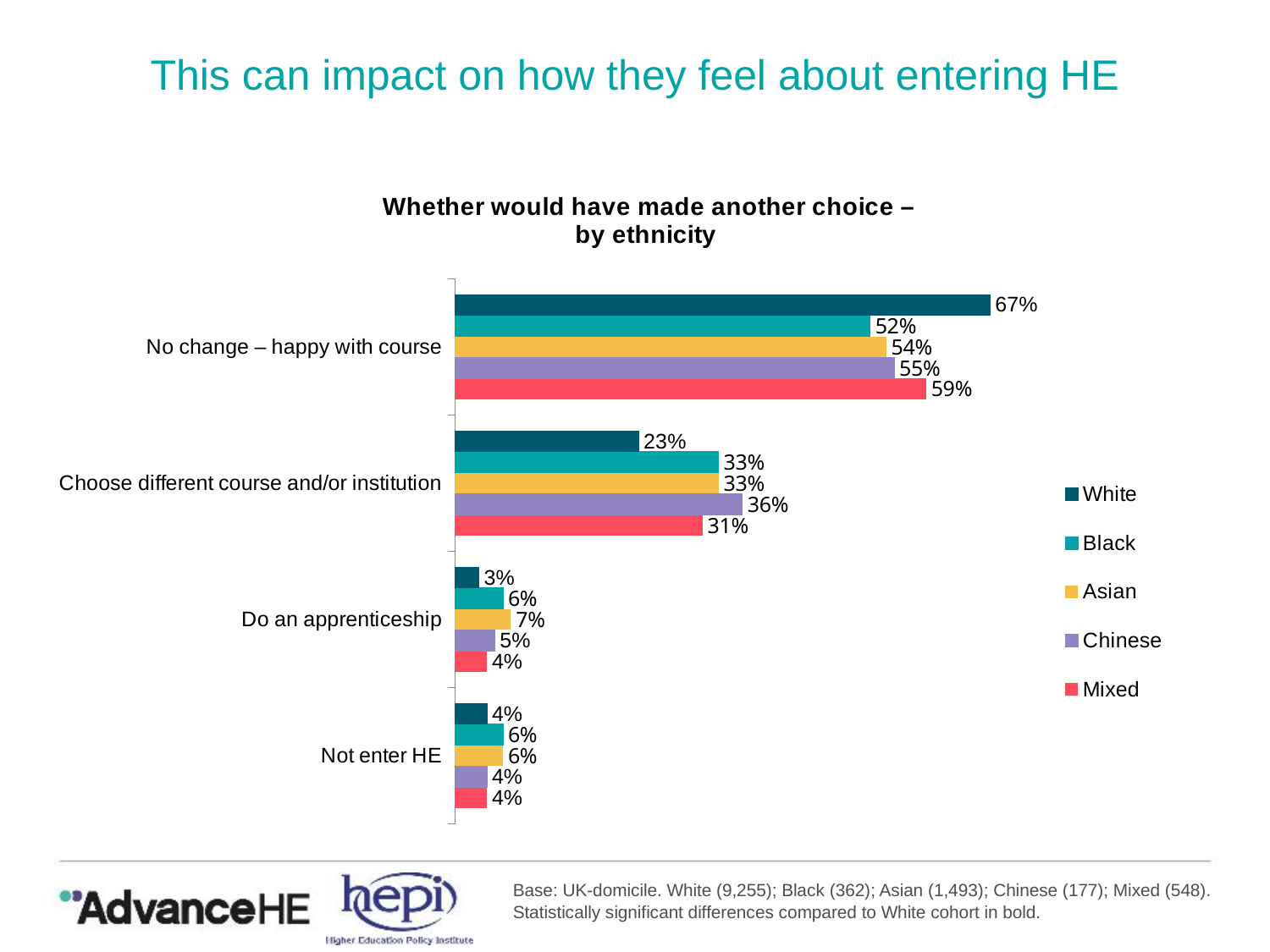
For 'Choose different course and/or institution', which is larger: the Black value or the Mixed value? Black Which ethnic group has the lowest value for 'Choose different course and/or institution'? White Which ethnic group has the highest value for 'No change – happy with course'? White What is the difference between the White and Black values for 'No change – happy with course'? 15 percentage points How many response categories are shown on the chart? 4 What percentage of Asian respondents said they would 'Do an apprenticeship'? 7% What percentage of White respondents said 'No change – happy with course'? 67% How many series does the legend list? 5 What kind of chart is shown on the slide? Bar chart Which colour represents the Mixed group in the legend? Red What is the title of the chart? Whether would have made another choice – by ethnicity What is the value for Chinese respondents for 'Choose different course and/or institution'? 36%